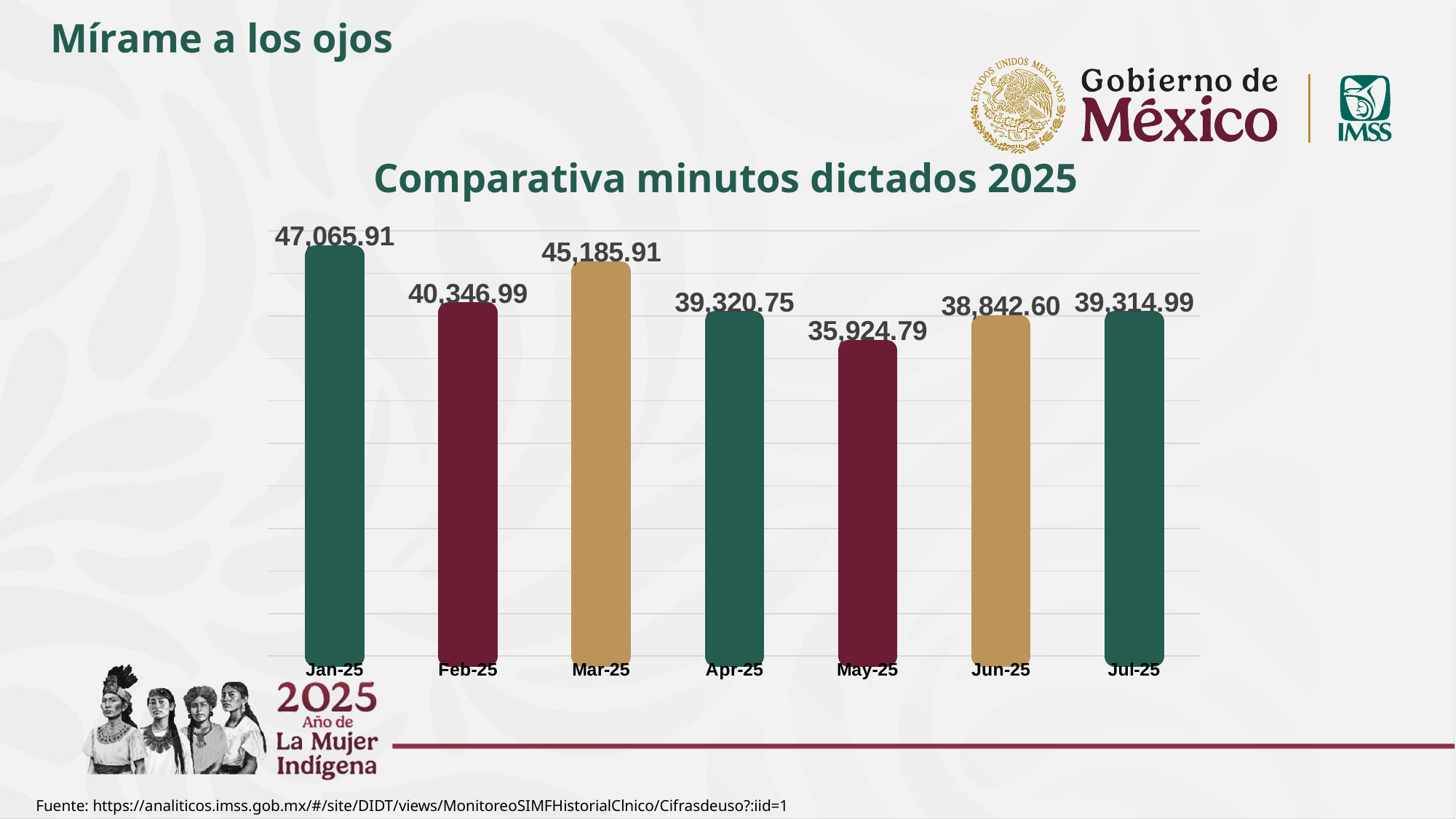
What is the difference between the values for Jan-25 and Feb-25? 6,718.92 What is the value for Jan-25? 47,065.91 What is the value for Jun-25? 38,842.60 What is the value for May-25? 35,924.79 Which month has the lowest value? May-25 What kind of chart is shown on the slide? Bar chart Which is larger, the value for Feb-25 or the value for Mar-25? Mar-25 Which month has the highest value? Jan-25 What is the difference between the values for Mar-25 and Apr-25? 5,865.16 How many months are shown on the chart? 7 What is the title of the chart? Comparativa minutos dictados 2025 What is the value for Mar-25? 45,185.91